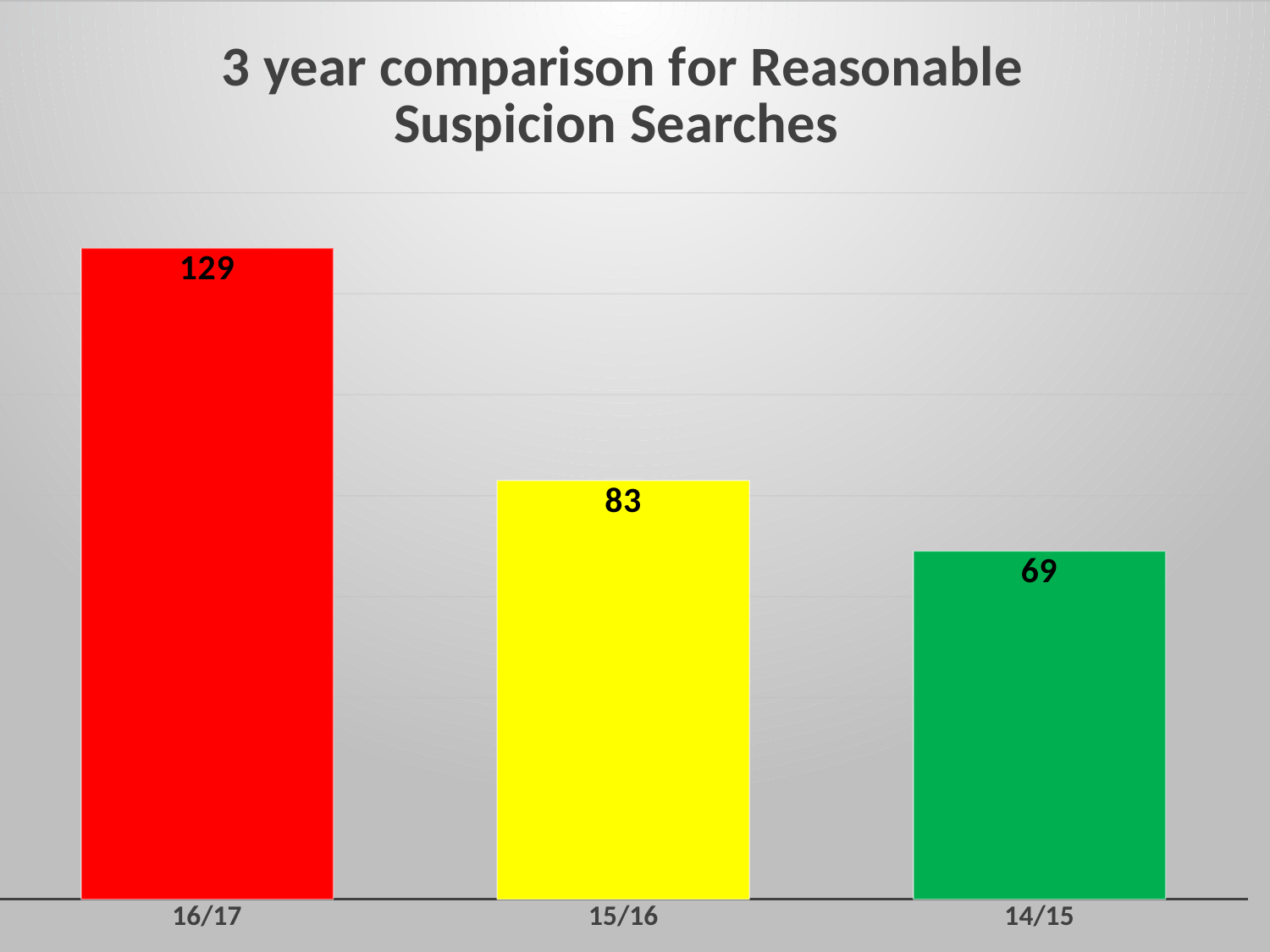
Which is larger, the value for 15/16 or the value for 14/15? 15/16 Do the values rise or fall from left to right along the x axis? fall What kind of chart is shown on the slide? bar chart What is the value for 14/15? 69 What is the value for 15/16? 83 What is the difference between the values for 16/17 and 15/16? 46 Which year has the highest value? 16/17 What is the difference between the values for 15/16 and 14/15? 14 How many categories are shown on the chart? 3 Which year has the lowest value? 14/15 What is the title of the chart? 3 year comparison for Reasonable Suspicion Searches What is the value for 16/17? 129